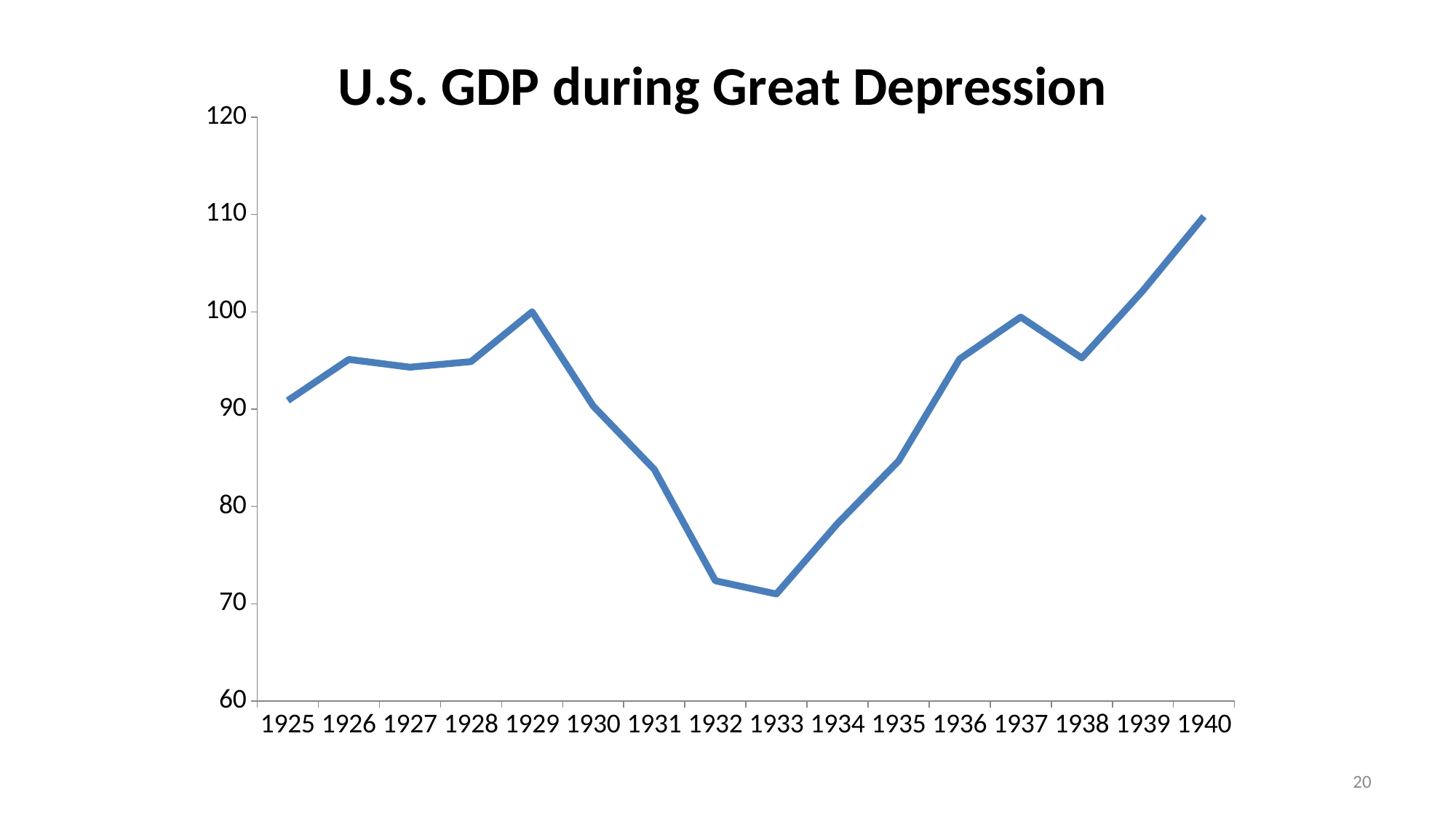
Which year has the highest GDP value? 1940 Which is larger, the value for 1929 or the value for 1925? 1929 How many years are plotted on the x axis? 16 Is the value for 1933 greater or less than 80? less Which is larger, the value for 1932 or the value for 1934? 1934 Is the value for 1931 greater or less than 90? less Which year has the lowest GDP value? 1933 Do the values rise or fall from 1929 to 1933? fall What kind of chart is shown on the slide? line chart Is the value for 1925 greater or less than 100? less What is the title of the chart? U.S. GDP during Great Depression